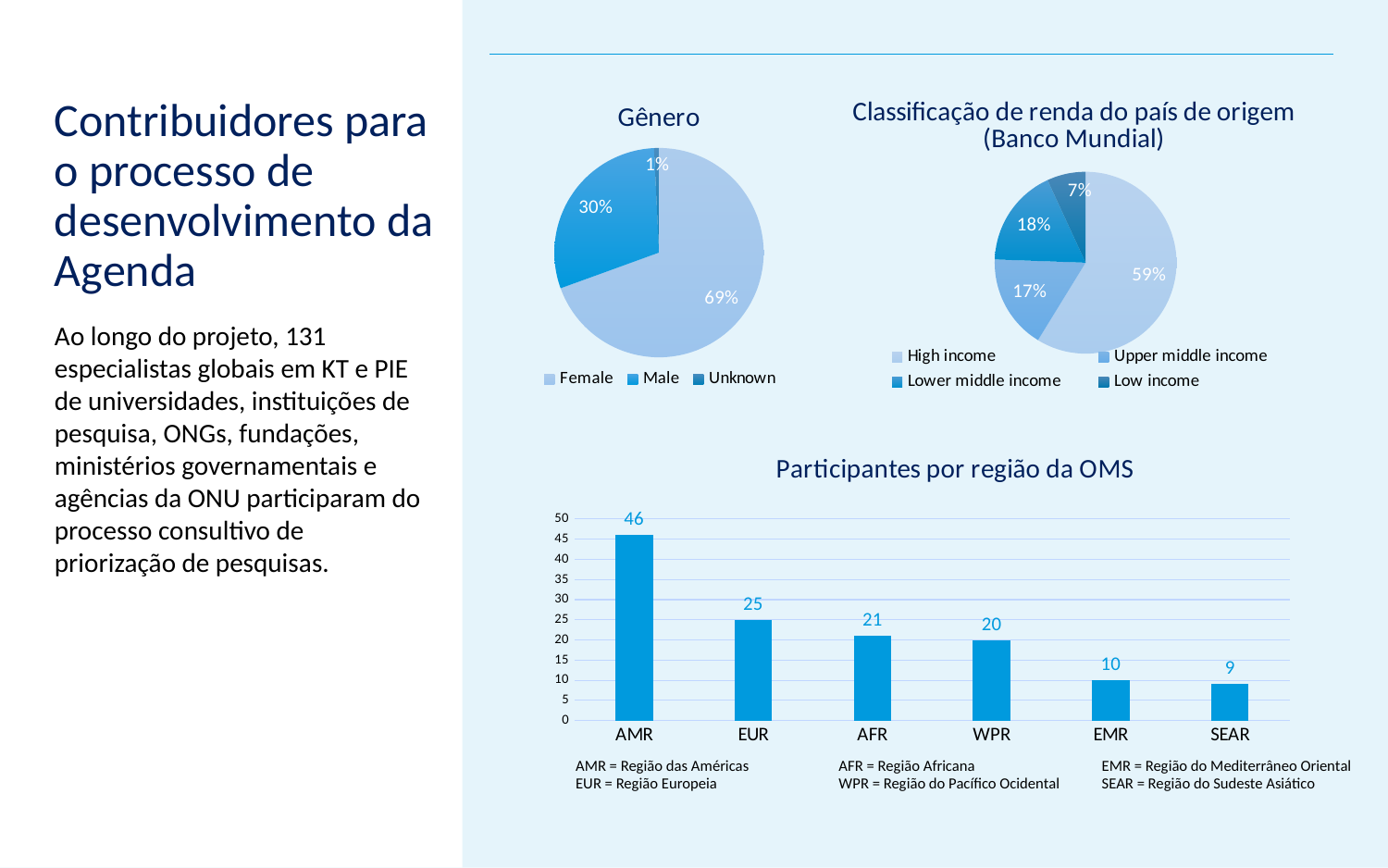
In the 'Participantes por região da OMS' chart, which region has the lowest value? SEAR What kind of chart is 'Participantes por região da OMS'? bar chart In the 'Gênero' pie chart, what share is Male? 30% In the 'Participantes por região da OMS' chart, what is the value for WPR? 20 In the 'Participantes por região da OMS' chart, what is the value for AMR? 46 In the 'Participantes por região da OMS' chart, how many regions are shown on the x axis? 6 In the 'Participantes por região da OMS' chart, what is the difference between the values for AMR and EUR? 21 In the 'Participantes por região da OMS' chart, which region has the highest value? AMR In the 'Gênero' pie chart, what share is Female? 69% How many entries does the legend of the 'Classificação de renda do país de origem (Banco Mundial)' pie chart list? 4 In the 'Classificação de renda do país de origem (Banco Mundial)' pie chart, what share is High income? 59% In the 'Participantes por região da OMS' chart, do the values rise or fall from left to right? fall